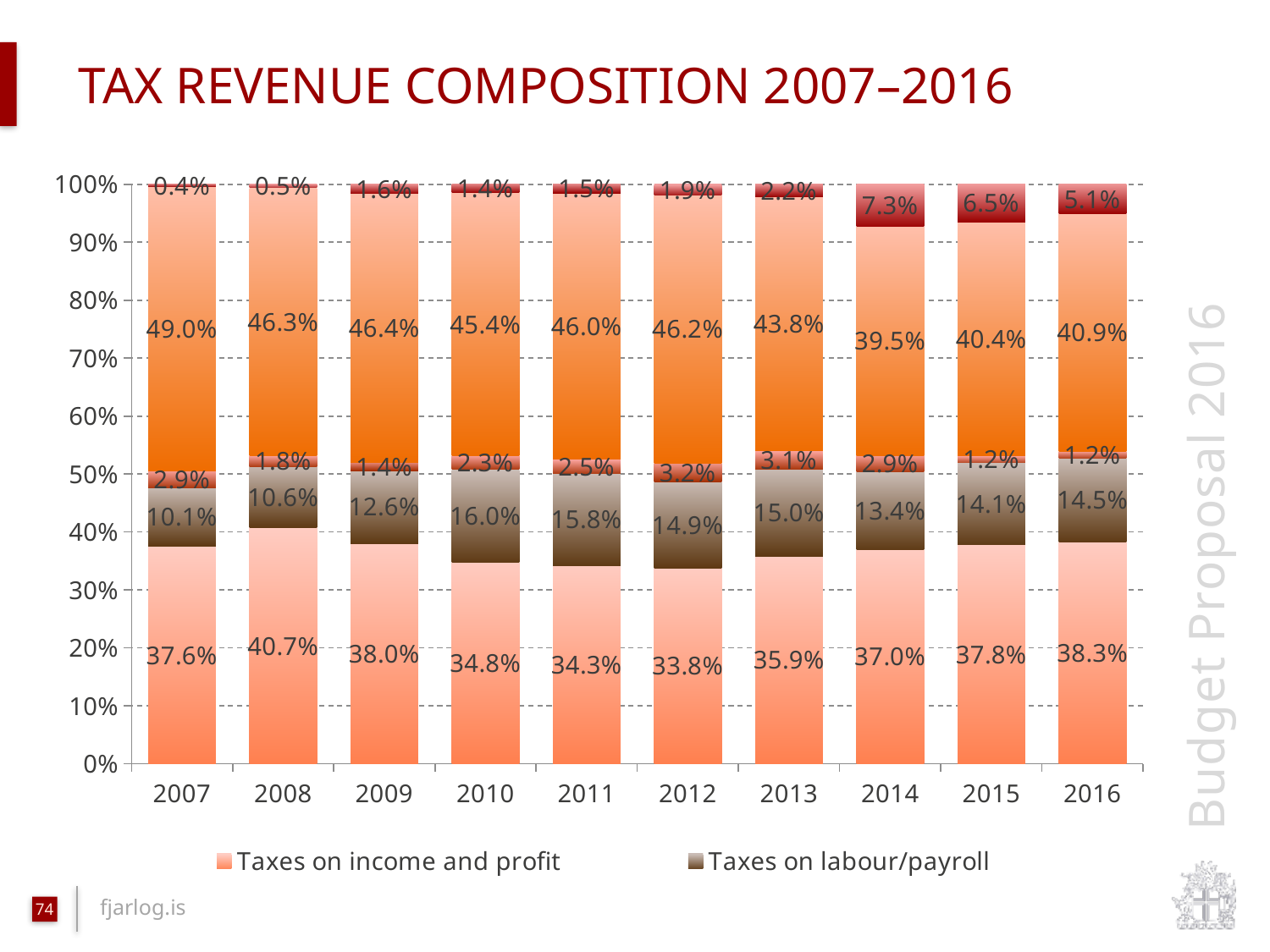
What is the value for Taxes on income and profit in 2012? 33.8% Does the share of Taxes on income and profit rise or fall from 2012 to 2016? Rise What is the value for Taxes on income and profit in 2016? 38.3% Which year has the larger share of Taxes on labour/payroll, 2009 or 2015? 2015 What kind of chart is shown on the slide? Stacked bar chart In which year is the share of Taxes on income and profit lowest? 2012 How many series does the legend list? 2 What is the value for Taxes on labour/payroll in 2010? 16.0% In which year is the share of Taxes on income and profit highest? 2008 By how many percentage points does Taxes on income and profit in 2008 exceed the 2007 value? 3.1 percentage points In which year is the share of Taxes on labour/payroll lowest? 2007 How many years are shown on the x axis? 10